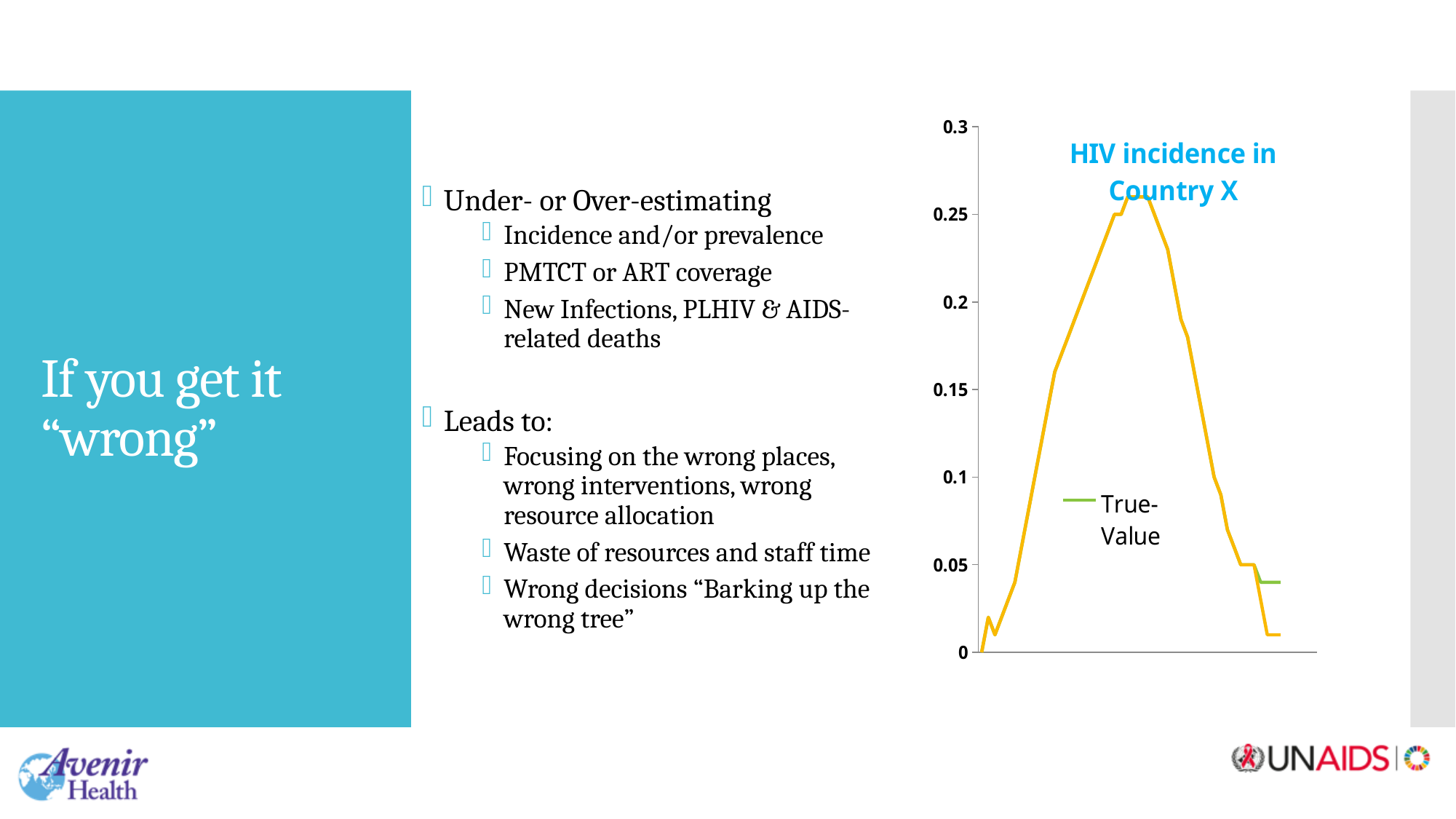
Is the value at the right-hand end of the HIV incidence line greater or less than 0.05? less How many series does the legend list? 1 What is the highest value shown on the y axis? 0.3 Is the value at the left-hand start of the HIV incidence line greater or less than 0.05? less What entry does the chart's legend list? True-Value What is the title of the chart? HIV incidence in Country X What kind of chart is shown on the slide? Line chart Does the HIV incidence line rise or fall over the second half of the x axis? Falls Does the HIV incidence line rise or fall over the first half of the x axis? Rises Is the peak value of the HIV incidence line greater or less than 0.2? greater